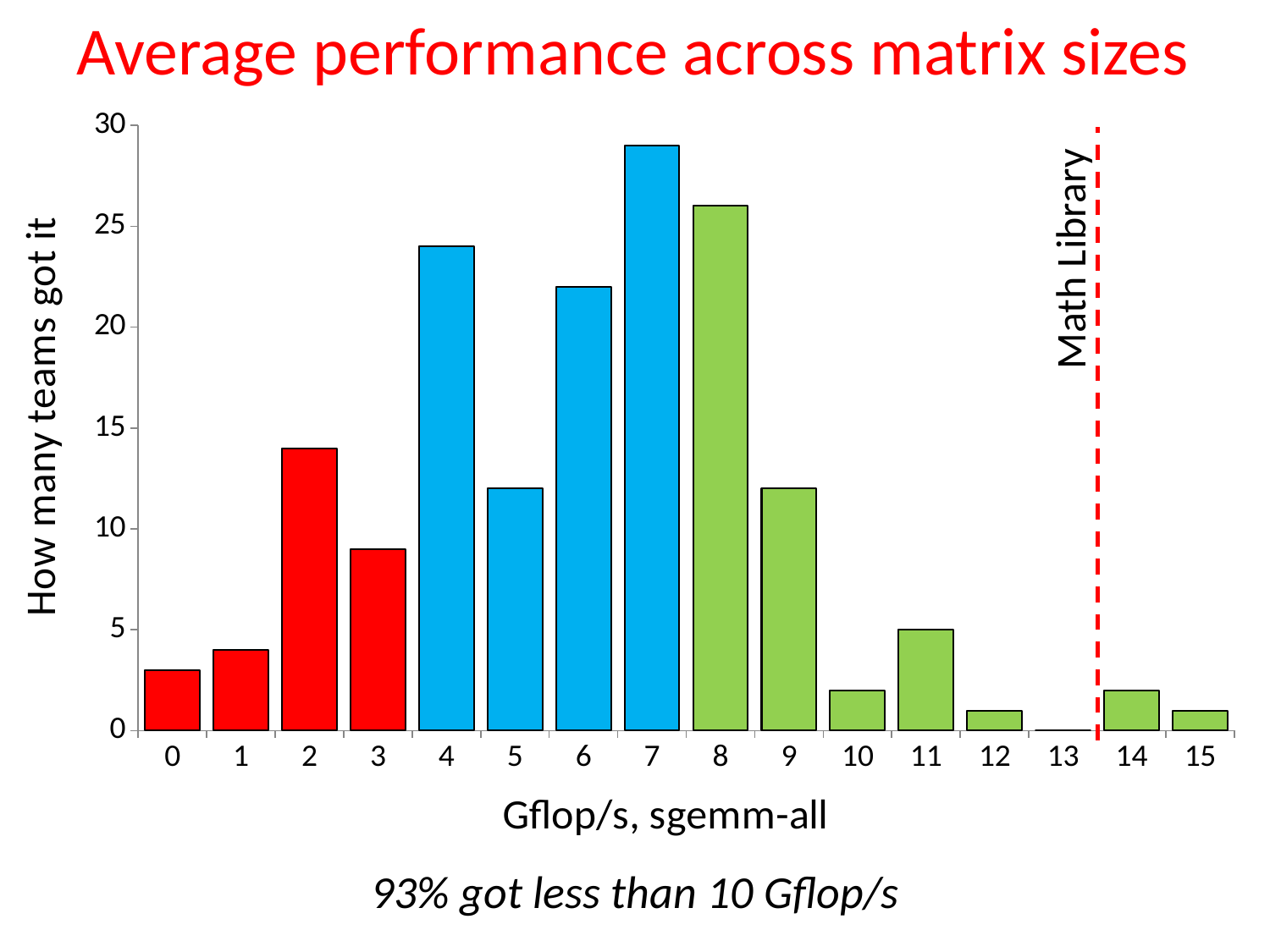
Is the value for 6 Gflop/s greater or less than 20? greater Which Gflop/s category has the lowest number of teams? 13 Is the value for 3 Gflop/s greater or less than 10? less Is the value for 7 Gflop/s greater or less than 25? greater How many categories are shown along the x axis? 16 What is the label of the x axis? Gflop/s, sgemm-all How many teams got 11 Gflop/s? 5 How many teams got 13 Gflop/s? 0 Which Gflop/s category has the highest number of teams? 7 Which has more teams, 4 Gflop/s or 6 Gflop/s? 4 Gflop/s What is the title of the chart? Average performance across matrix sizes What kind of chart is shown on the slide? bar chart